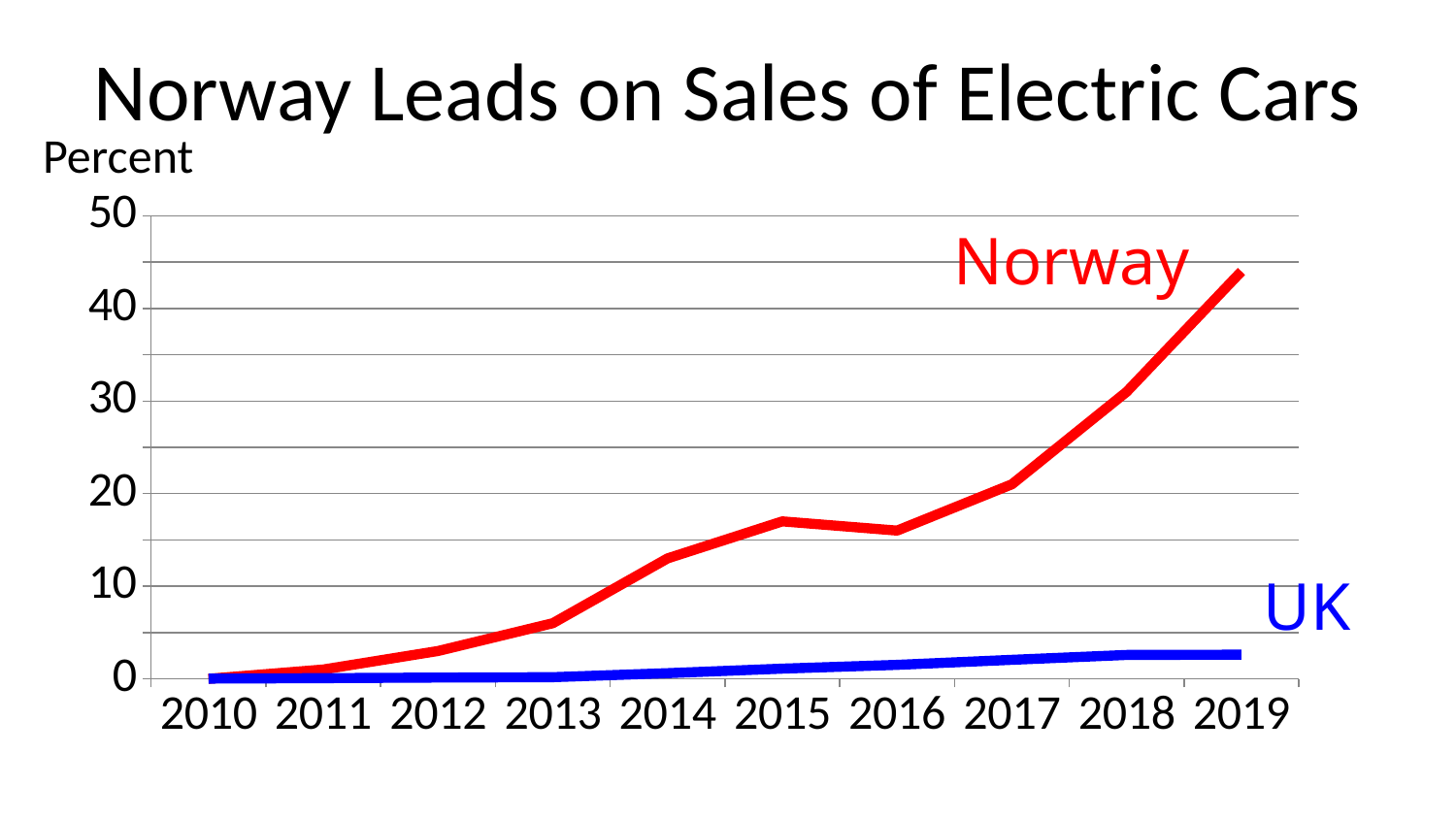
Which series has the higher value in 2019, Norway or UK? Norway What kind of chart is shown on the slide? line chart How many series are plotted on the chart? 2 Is the value for the UK in 2019 greater or less than 10? less Is the value for Norway in 2015 greater or less than 20? less What is the label on the vertical axis? Percent How many years are shown along the x axis? 10 Is the value for Norway in 2019 greater or less than 40? greater Does the Norway line rise or fall overall from 2010 to 2019? rise What is the title of the chart? Norway Leads on Sales of Electric Cars In which year does the Norway line reach its highest value? 2019